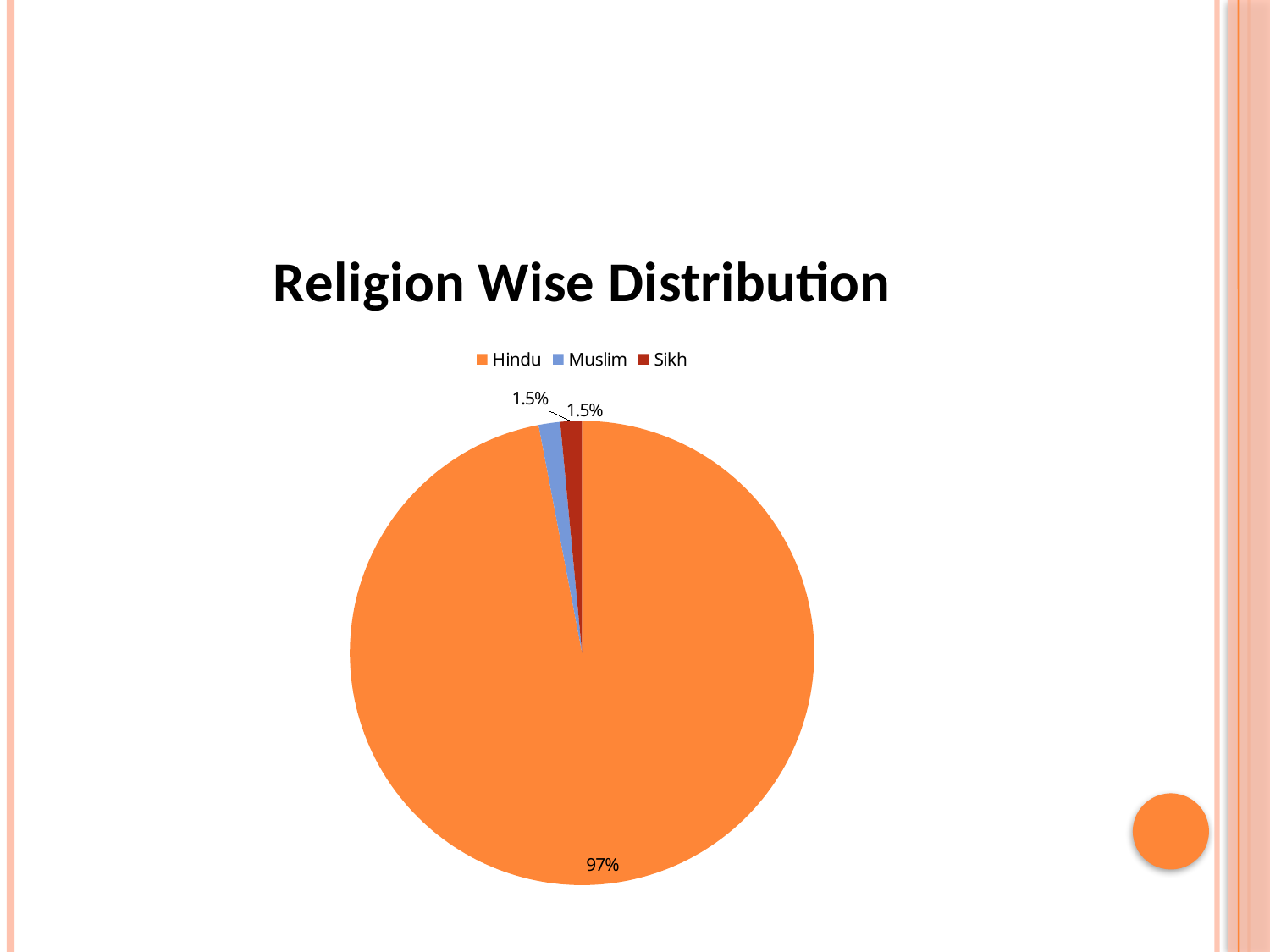
Which is larger, the Hindu slice or the Muslim slice? Hindu What is the difference between the Hindu share and the Sikh share? 95.5% What is the title of the chart? Religion Wise Distribution How many slices does the pie chart have? 3 What share of the pie does Sikh represent? 1.5% What share of the pie does Hindu represent? 97% Which colour represents Hindu in the pie chart? orange What type of chart is shown on the slide? pie chart Is the Hindu share greater or less than 90%? greater Which category has the largest slice of the pie? Hindu How many categories does the legend list? 3 What share of the pie does Muslim represent? 1.5%